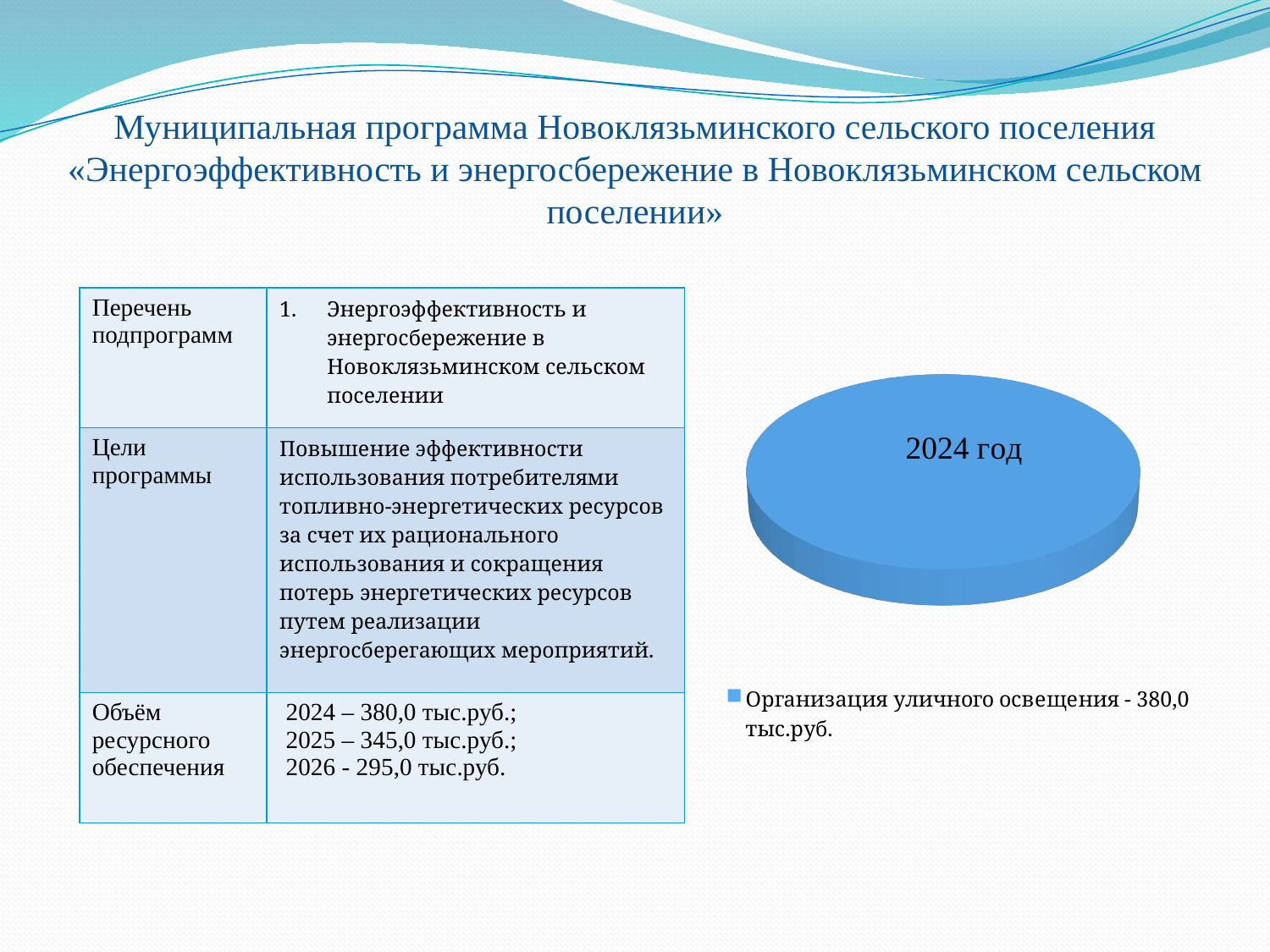
What category is shown in the legend of the pie chart? Организация уличного освещения - 380,0 тыс.руб. How many entries does the legend of the pie chart list? 1 Which year does the pie chart refer to? 2024 What share of the pie does the slice for Организация уличного освещения represent? 100% How many slices does the pie chart have? 1 What kind of chart is shown on the slide? pie chart What is the title of the pie chart? 2024 год What value is given for Организация уличного освещения in the pie chart legend? 380,0 тыс.руб.